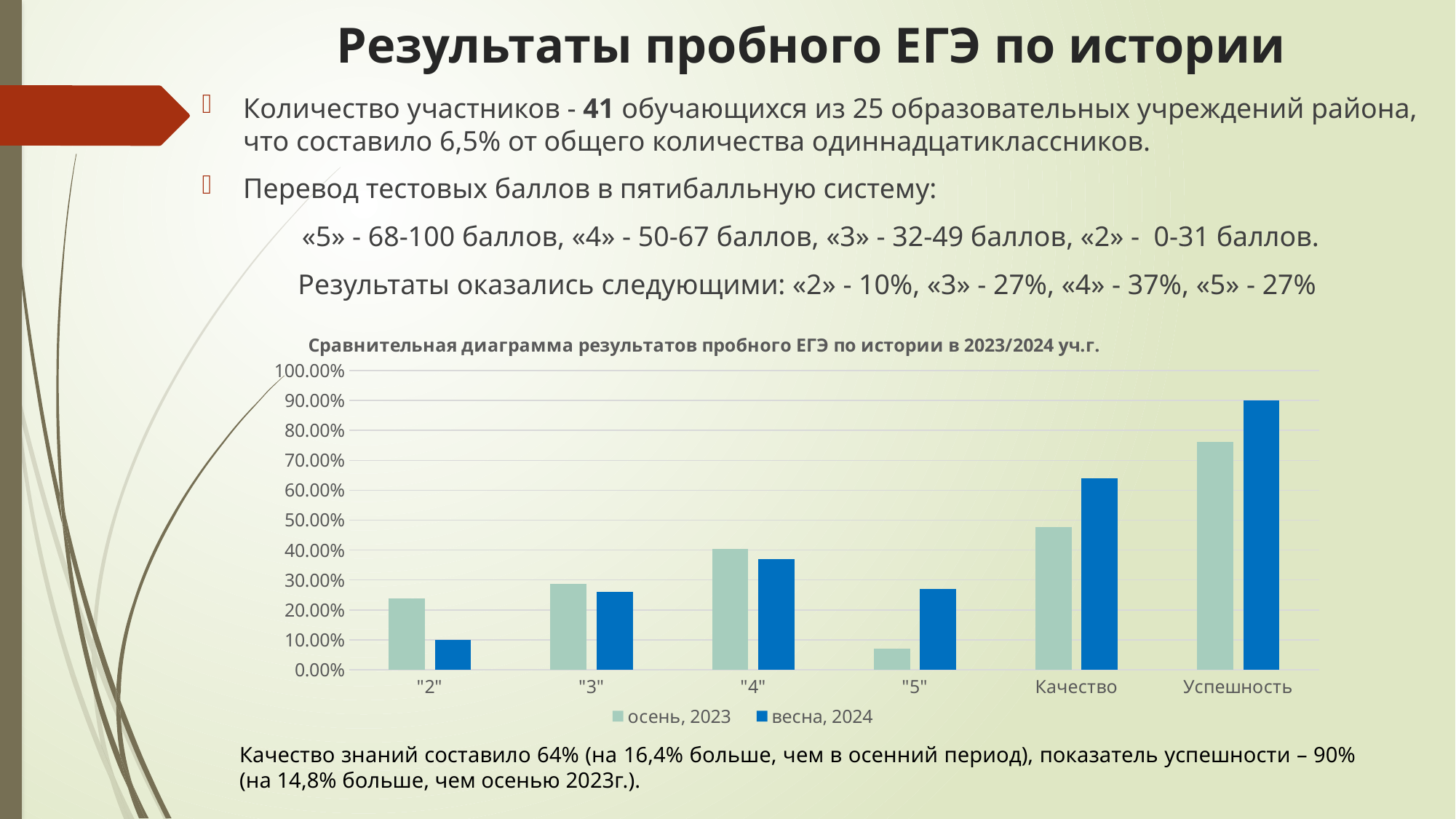
What is the value for Успешность in the весна, 2024 series? 90% How many categories are shown on the x axis of the chart? 6 Is the value for "5" in the осень, 2023 series greater or less than 10.00%? less Which bar is the lowest in the chart? "5" (осень, 2023) How many series does the chart legend list? 2 What kind of chart is shown on the slide? bar chart Which category has the highest bar in the chart? Успешность (весна, 2024) For category "5", which series has the larger value: осень, 2023 or весна, 2024? весна, 2024 What is the value for "2" in the весна, 2024 series? 10% Is the value for Успешность in the осень, 2023 series greater or less than 70.00%? greater What is the value for Качество in the весна, 2024 series? 64% For category "2", which series has the larger value: осень, 2023 or весна, 2024? осень, 2023